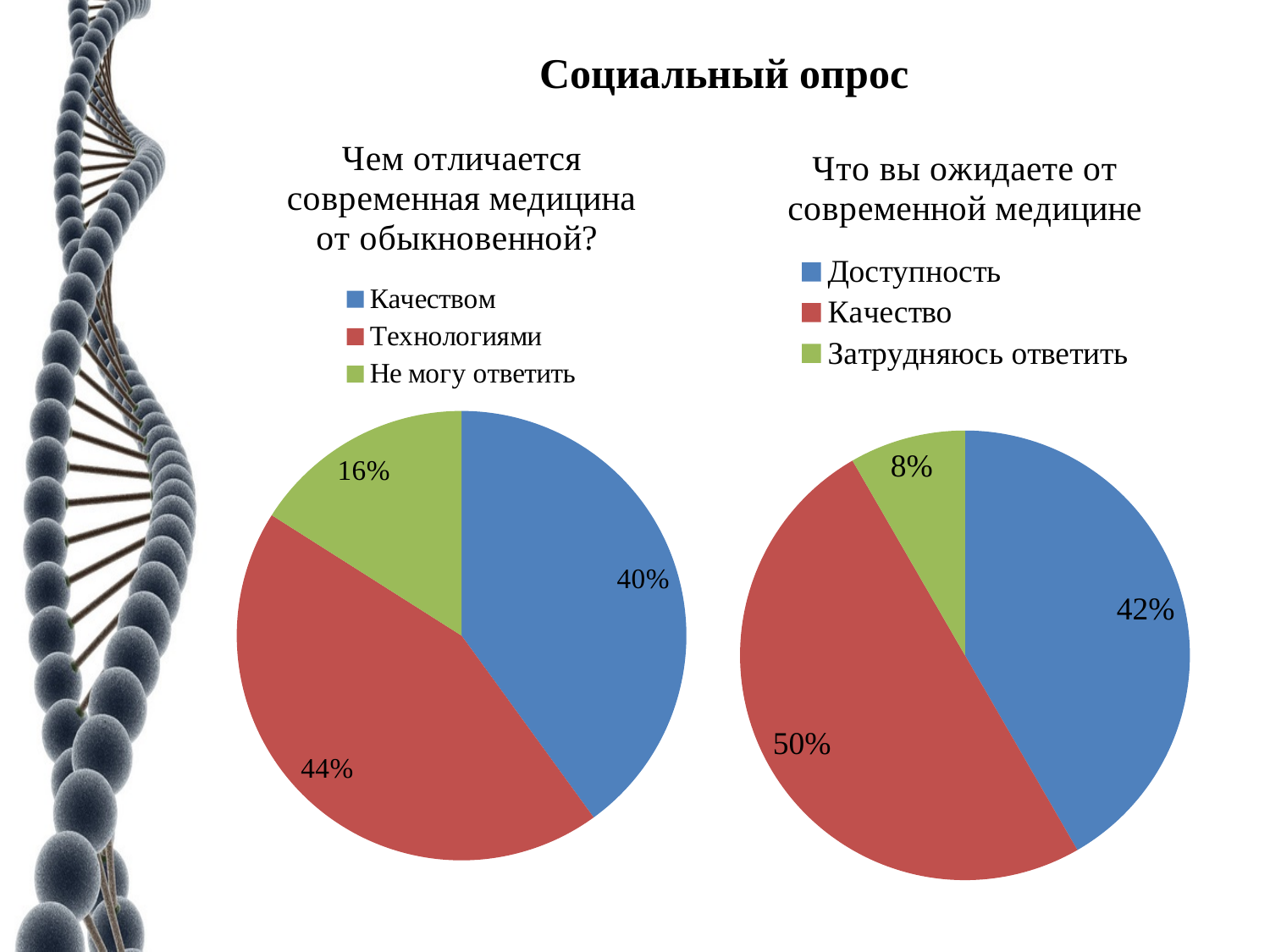
In the right pie chart 'Что вы ожидаете от современной медицине', what is the difference between Качество and Доступность? 8% In the left pie chart 'Чем отличается современная медицина от обыкновенной?', what share of the pie does Качеством take? 40% How many slices does the right pie chart 'Что вы ожидаете от современной медицине' have? 3 In the left pie chart 'Чем отличается современная медицина от обыкновенной?', which category has the largest share? Технологиями In the right pie chart 'Что вы ожидаете от современной медицине', what colour is the Качество slice? Red In the left pie chart 'Чем отличается современная медицина от обыкновенной?', what is the value for Технологиями? 44% In the left pie chart 'Чем отличается современная медицина от обыкновенной?', which is larger: Качеством or Не могу ответить? Качеством In the left pie chart 'Чем отличается современная медицина от обыкновенной?', what is the value for Не могу ответить? 16% What type of chart is the left chart 'Чем отличается современная медицина от обыкновенной?'? Pie chart In the right pie chart 'Что вы ожидаете от современной медицине', which category has the smallest share? Затрудняюсь ответить In the right pie chart 'Что вы ожидаете от современной медицине', what is the value for Доступность? 42% In the right pie chart 'Что вы ожидаете от современной медицине', what is the value for Затрудняюсь ответить? 8%